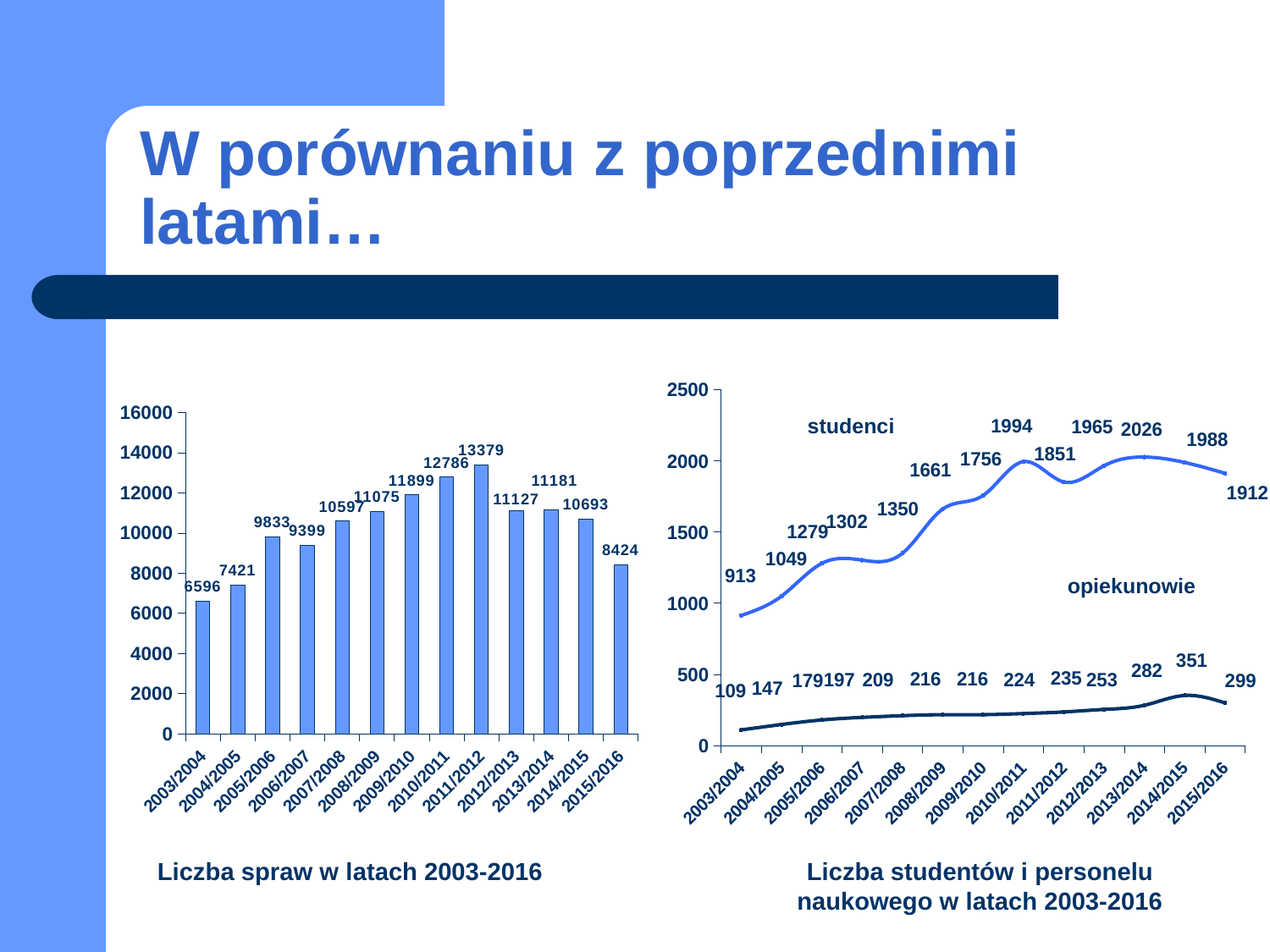
In the chart 'Liczba spraw w latach 2003-2016', what is the value for 2011/2012? 13379 In the chart 'Liczba spraw w latach 2003-2016', which year has the lowest value? 2003/2004 What kind of chart is 'Liczba spraw w latach 2003-2016'? bar chart In the chart 'Liczba studentów i personelu naukowego w latach 2003-2016', what is the value for studenci in 2013/2014? 2026 In the chart 'Liczba studentów i personelu naukowego w latach 2003-2016', how many series are plotted? 2 In the chart 'Liczba studentów i personelu naukowego w latach 2003-2016', is the value for studenci in 2003/2004 greater or less than 1000? less In the chart 'Liczba studentów i personelu naukowego w latach 2003-2016', what is the difference between the studenci values for 2003/2004 and 2015/2016? 999 In the chart 'Liczba studentów i personelu naukowego w latach 2003-2016', what is the value for opiekunowie in 2014/2015? 351 In the chart 'Liczba studentów i personelu naukowego w latach 2003-2016', which year has the highest value for opiekunowie? 2014/2015 In the chart 'Liczba spraw w latach 2003-2016', which year has the highest value? 2011/2012 In the chart 'Liczba spraw w latach 2003-2016', what is the difference between the values for 2011/2012 and 2015/2016? 4955 In the chart 'Liczba spraw w latach 2003-2016', how many years are shown on the x axis? 13